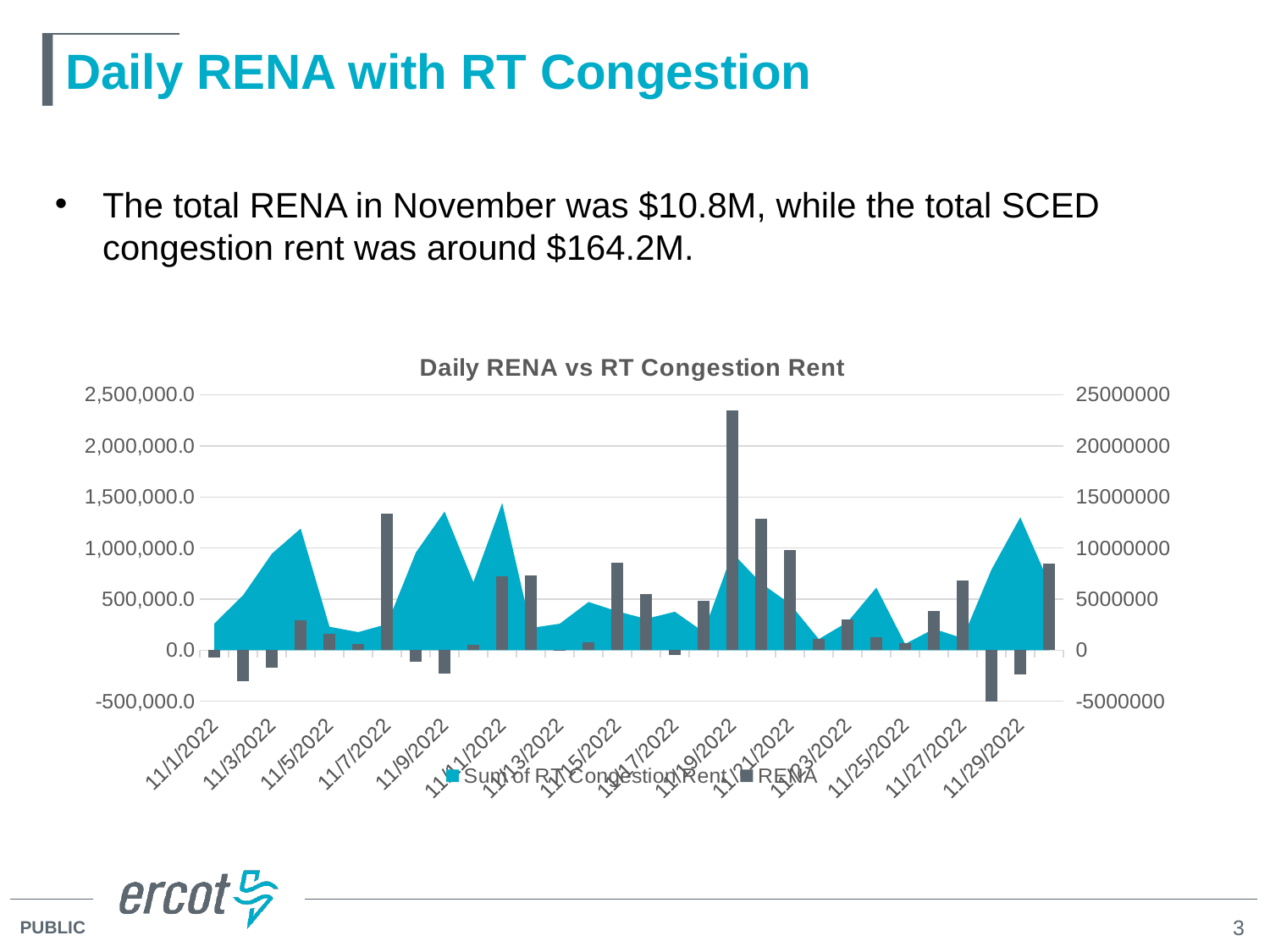
What is the title of the chart? Daily RENA vs RT Congestion Rent Is the RENA bar for 11/3/2022 greater or less than 0? less On which date does the RENA series have its highest bar? 11/19/2022 Is the RENA bar for 11/19/2022 greater or less than the 2,000,000.0 gridline on the left-hand axis? greater How many date labels are shown on the x axis? 15 Which is larger, the RENA bar for 11/19/2022 or the RENA bar for 11/7/2022? 11/19/2022 What is the highest value shown on the right-hand axis of the chart? 25000000 Is the RENA bar for 11/7/2022 greater or less than the 1,000,000.0 gridline on the left-hand axis? greater How many series does the chart legend list? 2 Which is larger, the RENA bar for 11/5/2022 or the RENA bar for 11/3/2022? 11/5/2022 What kind of chart is used to show the RENA series? Bar chart What are the two series named in the chart legend? Sum of RT Congestion Rent and RENA